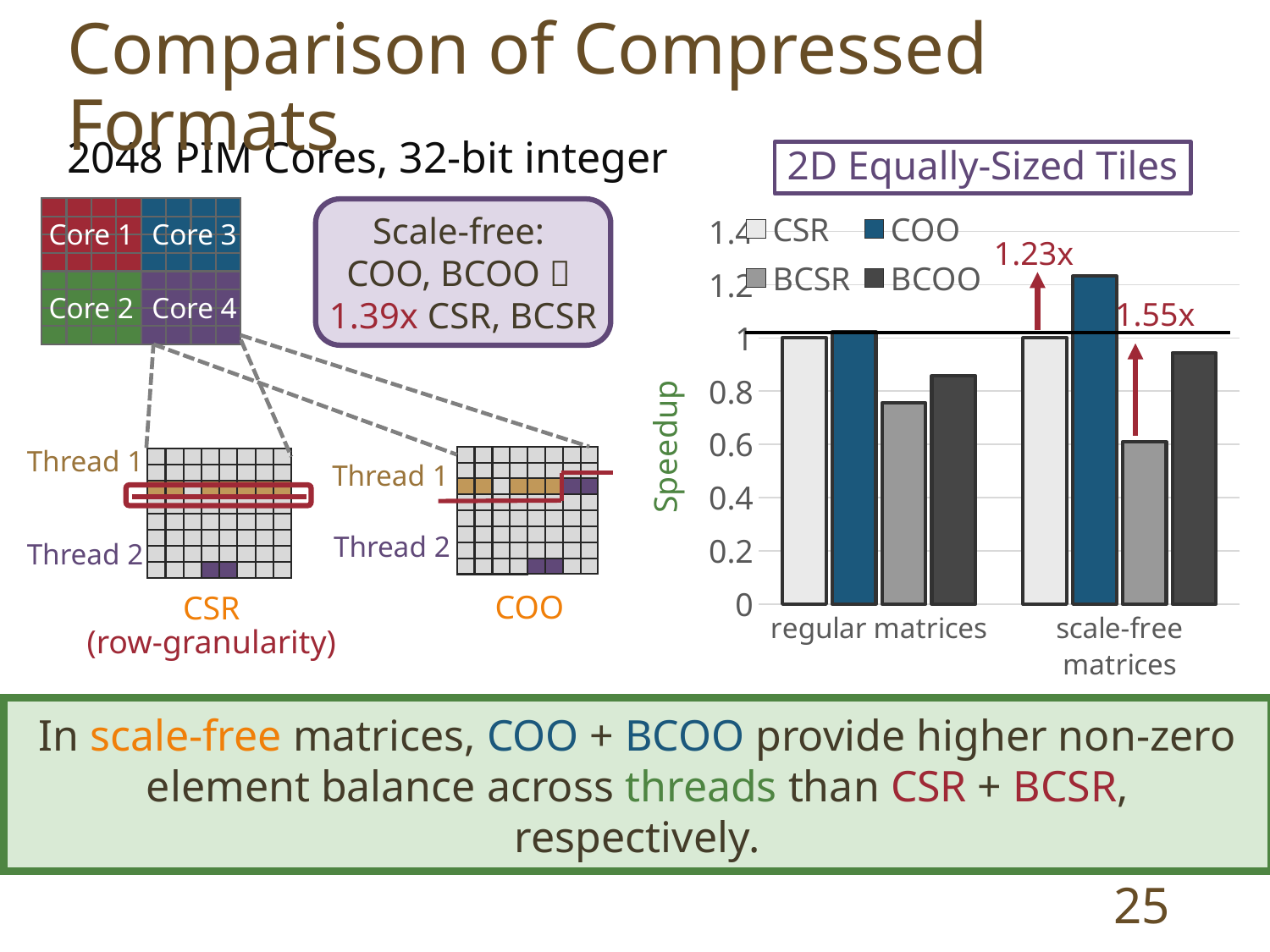
How many series does the legend of the chart list? 4 What kind of chart is shown on the slide? bar chart Is the speedup of BCSR for scale-free matrices greater or less than 0.8? less Is the speedup of COO higher for regular matrices or for scale-free matrices? scale-free matrices Is the speedup of COO for scale-free matrices greater or less than 1? greater Which format has the lowest speedup for scale-free matrices? BCSR What is the label of the y axis of the chart? Speedup Which format has the highest speedup for scale-free matrices? COO What is the title of the chart? 2D Equally-Sized Tiles Does the speedup of BCSR rise or fall from regular matrices to scale-free matrices? fall How many categories are shown on the x axis of the chart? 2 Which format has the lowest speedup for regular matrices? BCSR